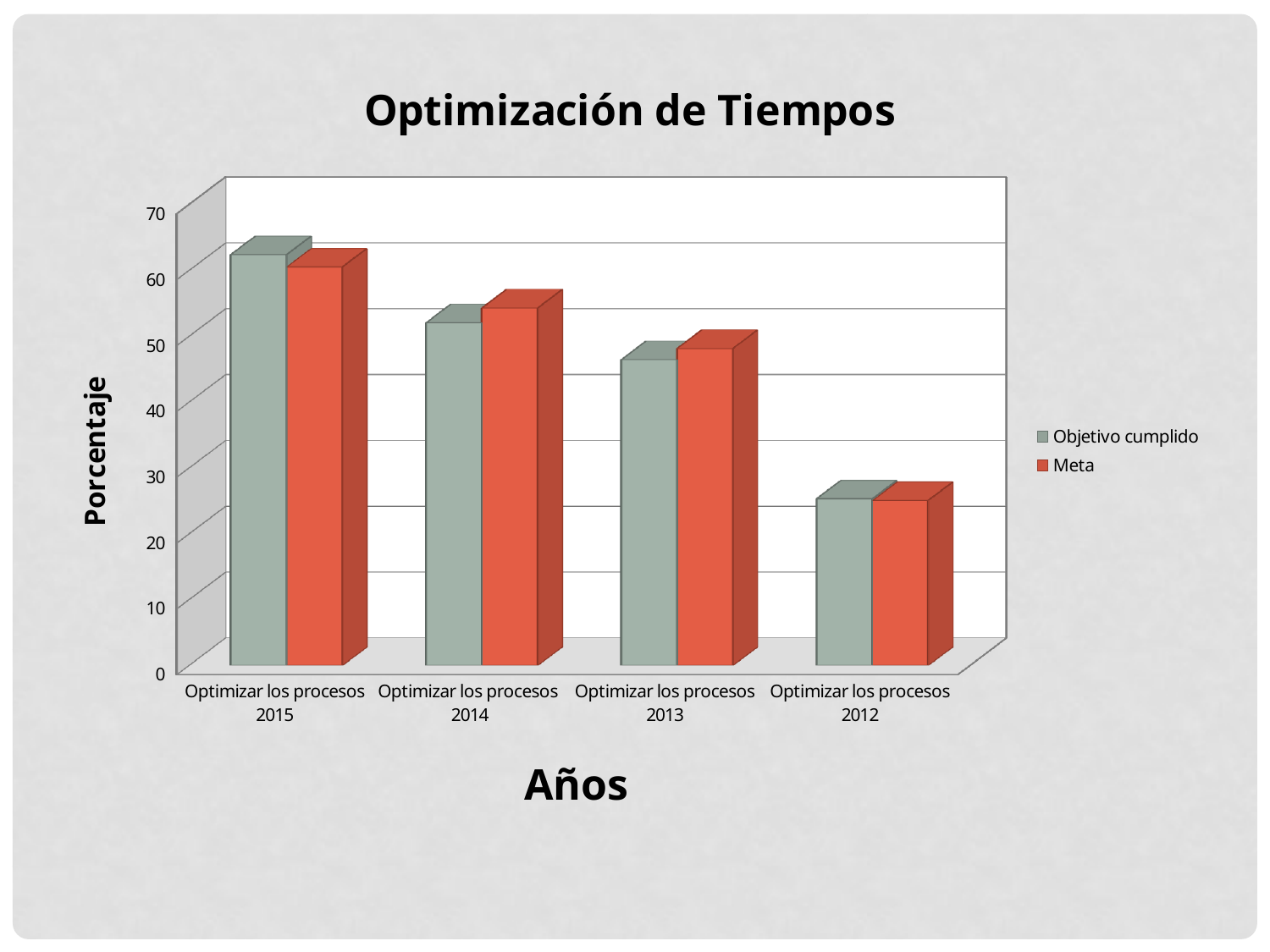
Is the Meta value for Optimizar los procesos 2014 greater or less than 50? greater What is the title of the chart? Optimización de Tiempos What are the two series named in the legend? Objetivo cumplido and Meta How many categories are shown on the x axis? 4 What kind of chart is shown on the slide? bar chart Is the Objetivo cumplido value for Optimizar los procesos 2015 greater or less than 50? greater Which category has the highest value for Objetivo cumplido? Optimizar los procesos 2015 How many series does the legend list? 2 Which category has the lowest value for Meta? Optimizar los procesos 2012 Do the Objetivo cumplido values rise or fall moving left to right along the x axis? fall Is the Objetivo cumplido value for Optimizar los procesos 2012 greater or less than 30? less Which is larger, the Meta value for Optimizar los procesos 2015 or for Optimizar los procesos 2013? Optimizar los procesos 2015